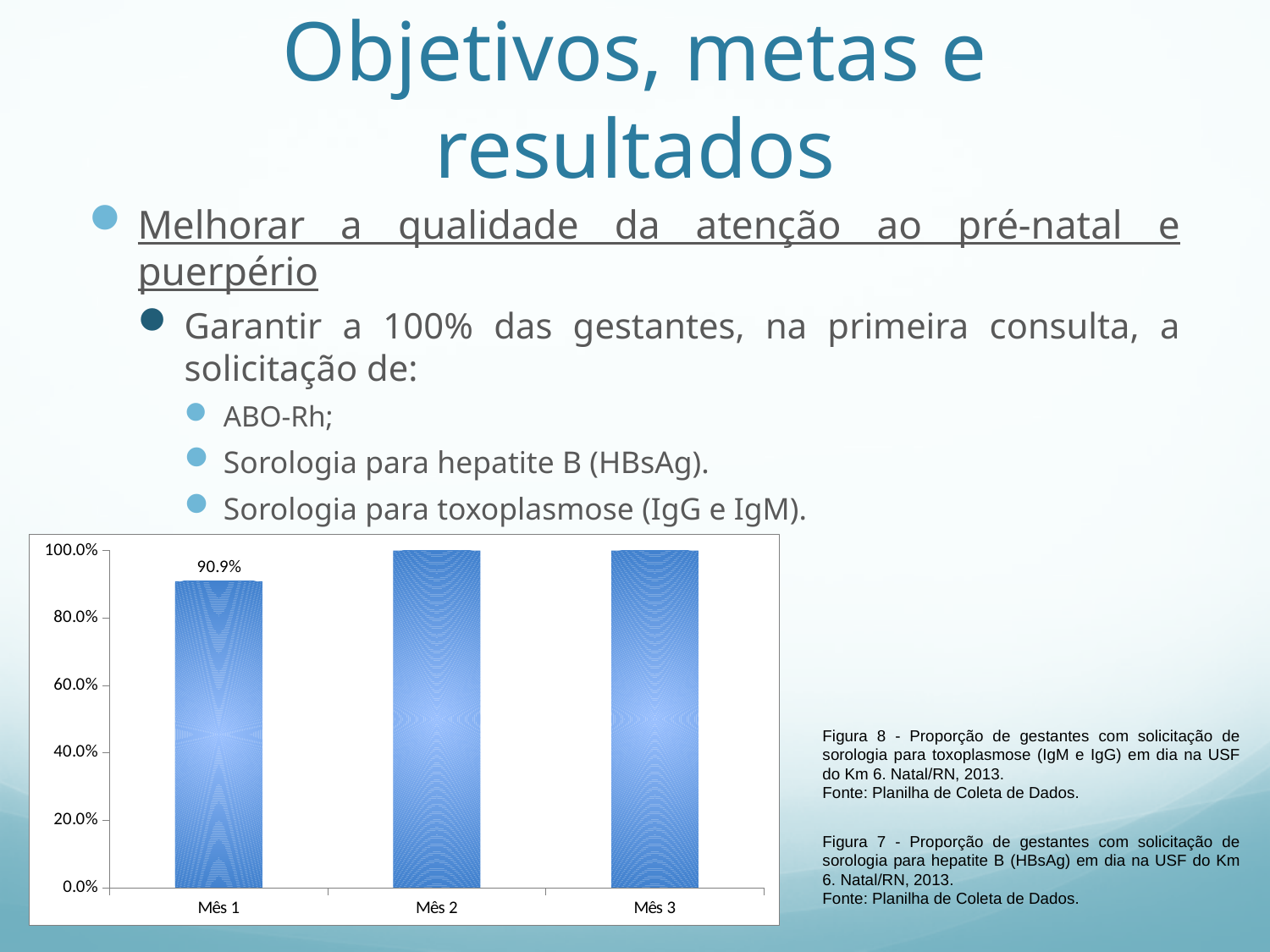
What is the value for Mês 1? 90.9% What is the difference between the value for Mês 2 (100.0%) and the value for Mês 1? 9.1% How many months (categories) are shown on the x axis? 3 Does the value rise or fall from Mês 1 to Mês 2? Rise Which month has the lowest value? Mês 1 What is the label of the first category on the x axis? Mês 1 What kind of chart is shown on the slide? Bar chart Is the value for Mês 3 greater or less than 80.0%? greater Is the value for Mês 1 greater or less than 100.0%? less Which is larger, the value for Mês 1 or the value for Mês 2? Mês 2 What is the highest tick value shown on the y axis? 100.0% What value does the bar for Mês 2 reach on the y axis? 100.0%